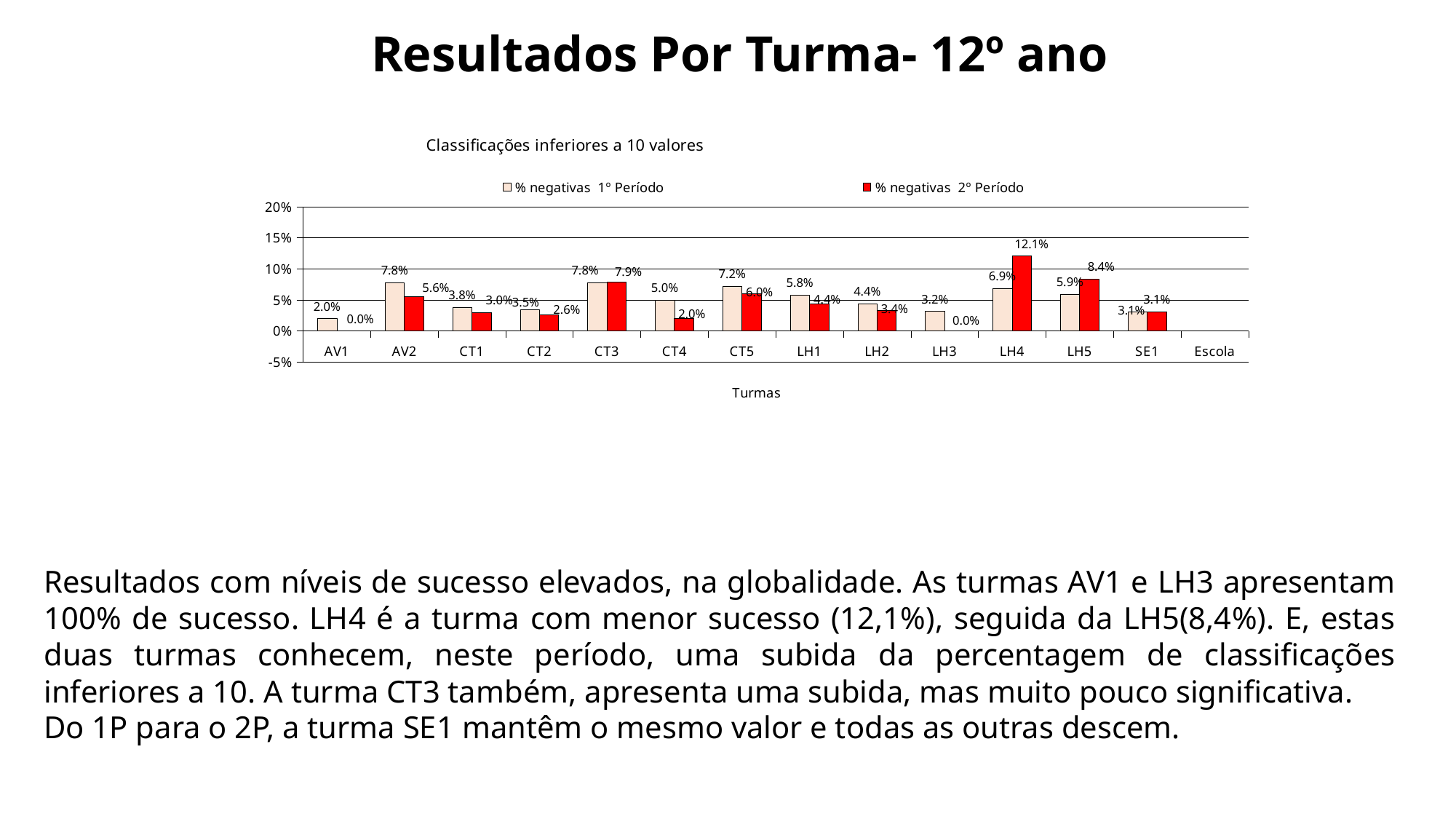
What is the difference between the 1º Período and 2º Período values for LH4? 5.2% What is the title of the chart? Classificações inferiores a 10 valores What is the value of % negativas 1º Período for AV2? 7.8% How many series does the legend list? 2 What is the value of % negativas 2º Período for LH4? 12.1% What is the difference between the 1º Período and 2º Período values for CT4? 3.0% Which turma has the highest % negativas 2º Período? LH4 Which is larger for LH5: the 1º Período value or the 2º Período value? 2º Período What is the value of % negativas 2º Período for CT4? 2.0% What kind of chart is shown on the slide? Bar chart Which turma has the lowest % negativas 1º Período? AV1 Which is larger for AV2: the 1º Período value or the 2º Período value? 1º Período